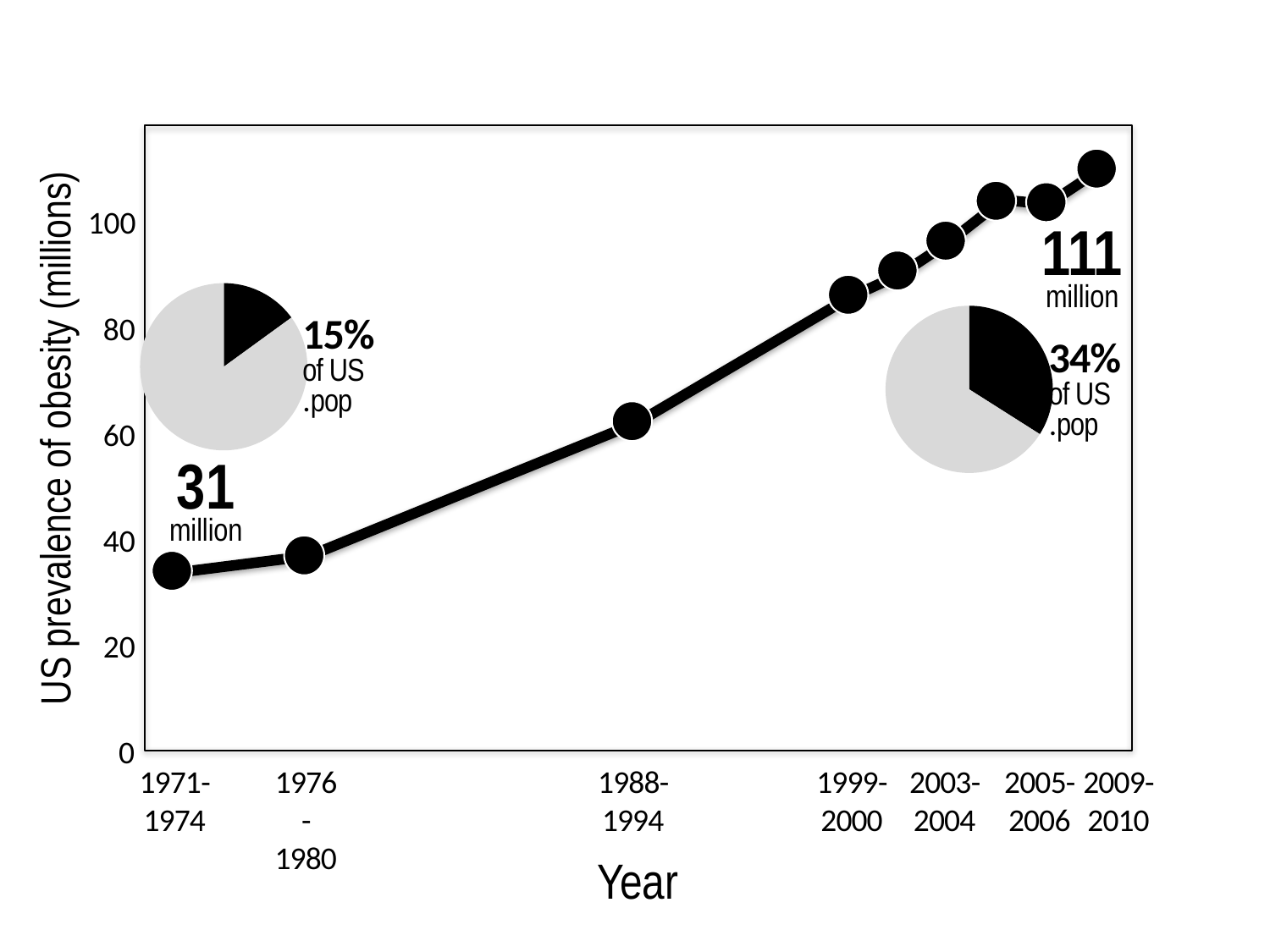
By how much did the labelled US prevalence of obesity increase from 1971-1974 to 2009-2010? 80 million Is the value for 1999-2000 greater or less than 80? greater Which period has the highest US prevalence of obesity on the line chart? 2009-2010 Do the values on the line chart rise or fall from 1971-1974 to 2009-2010? rise How many data points are plotted on the line chart? 9 Which is larger, the value for 1988-1994 or the value for 1999-2000? 1999-2000 What is the US prevalence of obesity labelled for the 2009-2010 point? 111 million What kind of chart is the main chart on the slide? line chart What share of the US population does the right-hand pie chart show as obese? 34% What is the US prevalence of obesity labelled for the 1971-1974 point? 31 million Which period has the lowest US prevalence of obesity on the line chart? 1971-1974 Is the value for 1988-1994 greater or less than 80? less